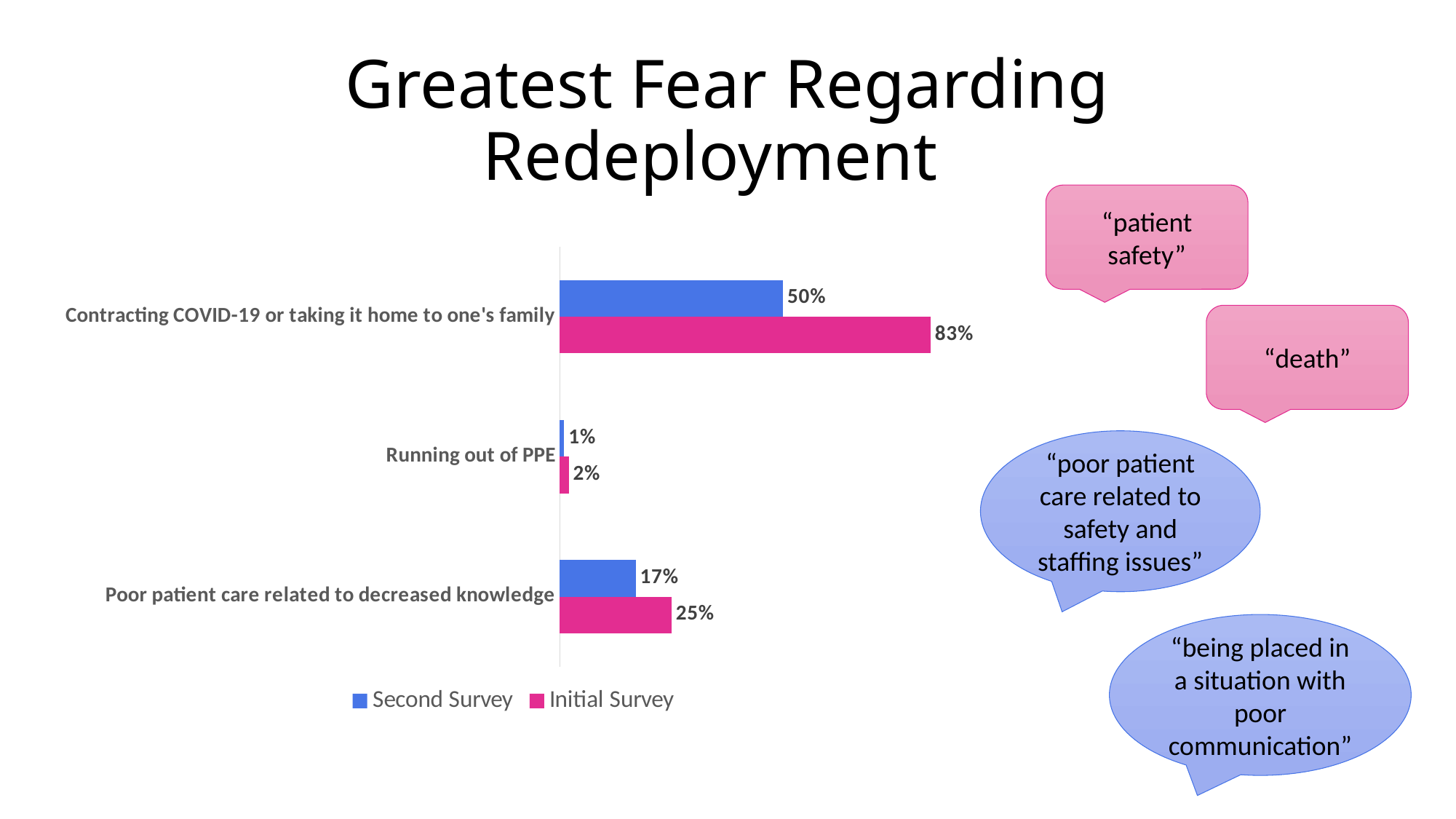
Which category has the lowest Second Survey value? Running out of PPE What is the Second Survey value for "Poor patient care related to decreased knowledge"? 17% Which colour represents the Initial Survey series in the chart? Pink How many categories are shown on the chart? 3 What kind of chart is shown on the slide? Bar chart Which is larger for "Running out of PPE": the Initial Survey value or the Second Survey value? Initial Survey How many series does the legend list? 2 What is the Initial Survey value for "Contracting COVID-19 or taking it home to one's family"? 83% What is the difference between the Initial Survey and Second Survey values for "Contracting COVID-19 or taking it home to one's family"? 33% What is the difference between the Initial Survey and Second Survey values for "Poor patient care related to decreased knowledge"? 8% What is the Second Survey value for "Running out of PPE"? 1% Which category has the highest Initial Survey value? Contracting COVID-19 or taking it home to one's family